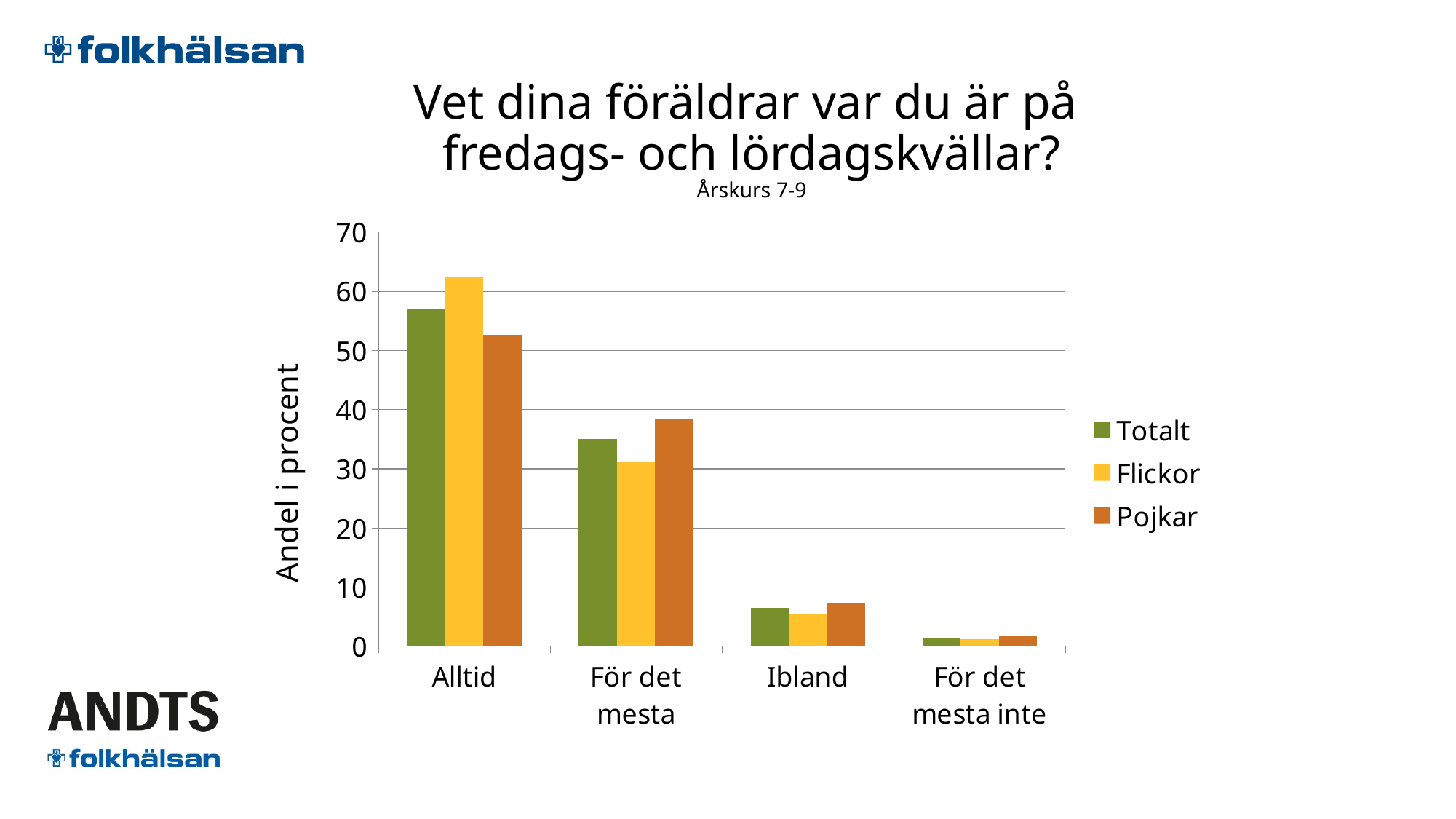
Which category has the lowest value for Totalt? För det mesta inte Which series has the highest value in the För det mesta category? Pojkar What kind of chart is shown on the slide? bar chart Which is larger in the Alltid category, Totalt or Pojkar? Totalt Is the value for Pojkar in the För det mesta category greater or less than 40? less Is the value for Totalt in the Ibland category greater or less than 10? less Which category has the highest value for Flickor? Alltid How many series does the legend list? 3 How many categories are shown on the x axis? 4 Is the value for Flickor in the Alltid category greater or less than 60? greater Which series has the highest value in the Alltid category? Flickor Do the Totalt values rise or fall from Alltid to För det mesta inte? fall